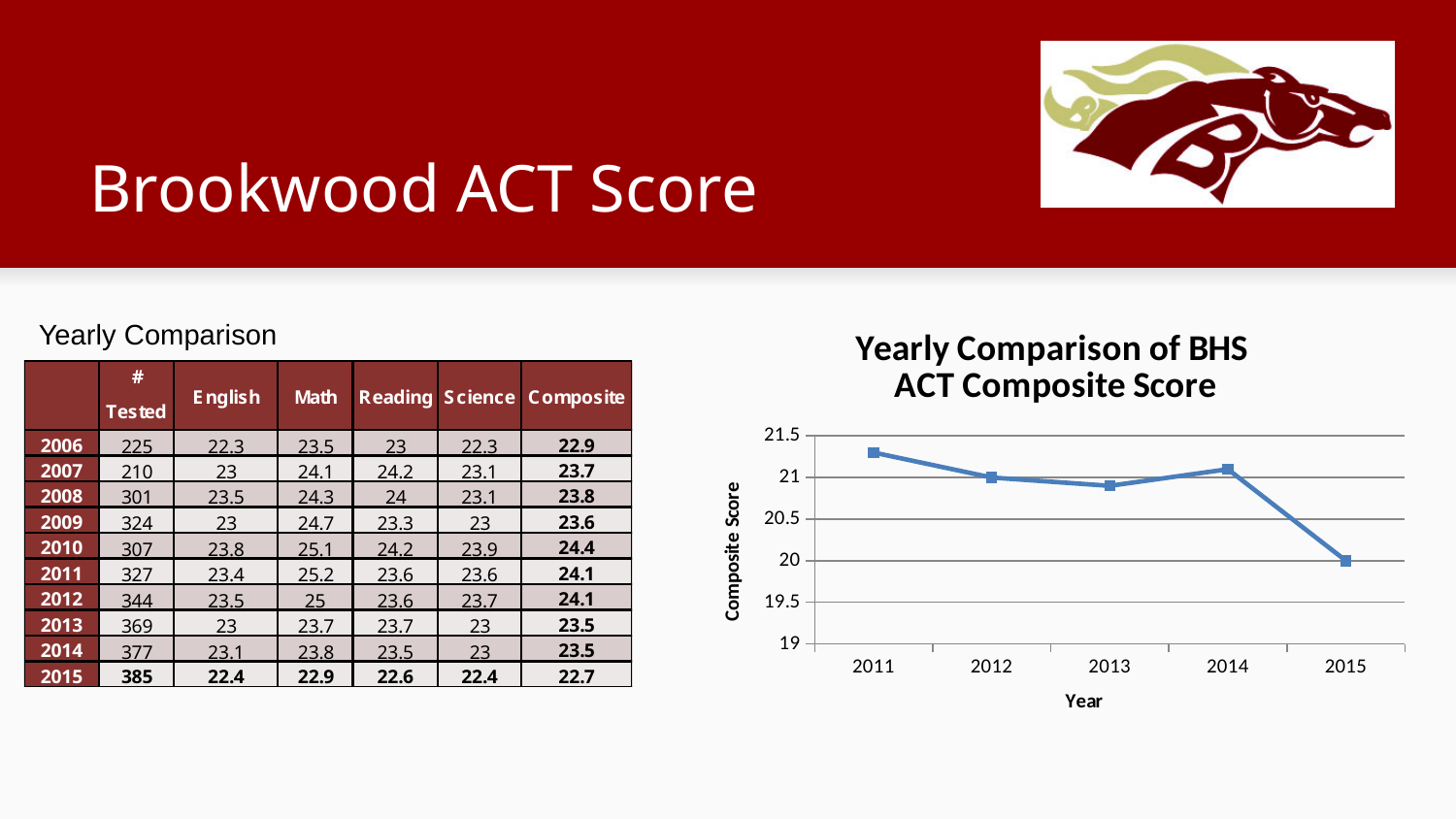
Is the composite score for 2011 greater or less than 21? greater Which year has the highest composite score on the chart? 2011 Is the composite score for 2015 greater or less than 20.5? less Is the composite score for 2014 greater or less than 20.5? greater What kind of chart is shown on the slide? line chart Which year has a higher composite score on the chart, 2014 or 2015? 2014 Does the composite score on the chart overall rise or fall from 2011 to 2015? fall What is the label of the vertical axis on the chart? Composite Score Which year has the lowest composite score on the chart? 2015 How many years are plotted on the chart? 5 What is the title of the chart on the slide? Yearly Comparison of BHS ACT Composite Score Which year has a higher composite score on the chart, 2011 or 2015? 2011